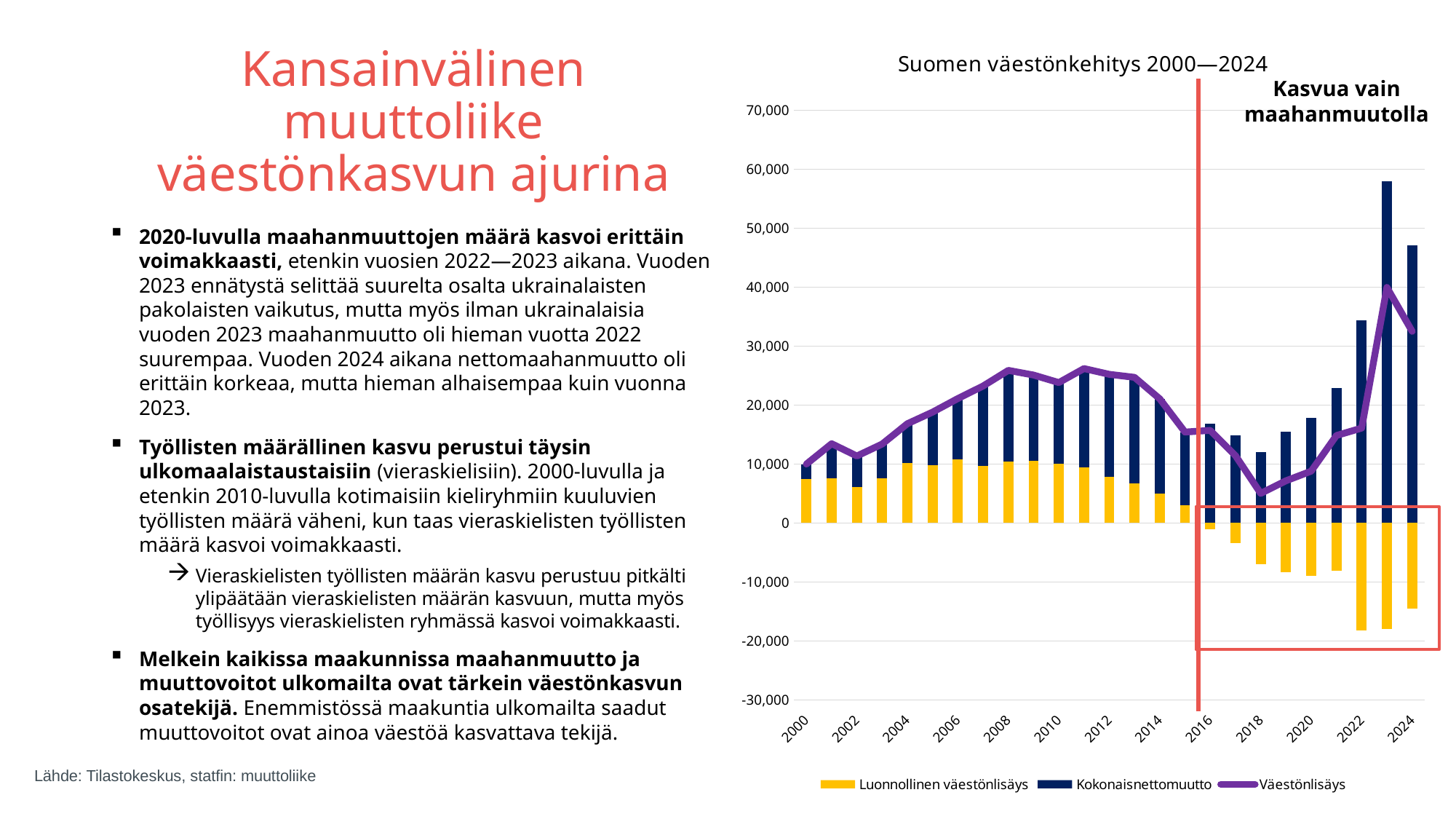
How many series does the chart legend list? 3 Is the Väestönlisäys value for 2018 greater or less than 10,000? less What is the title of the chart? Suomen väestönkehitys 2000—2024 How many years are plotted on the x axis of the chart? 25 Which colour represents Luonnollinen väestönlisäys in the chart? Yellow Does the Luonnollinen väestönlisäys value rise or fall from 2016 to 2022? fall In which year is the Kokonaisnettomuutto bar highest? 2023 Is the Väestönlisäys value for 2008 greater or less than 20,000? greater Which is larger, the Kokonaisnettomuutto value for 2022 or for 2023? 2023 Is the Kokonaisnettomuutto value for 2023 greater or less than 50,000? greater What kind of chart is shown on the slide? Bar chart with a line In which year does the Väestönlisäys line reach its highest point? 2023